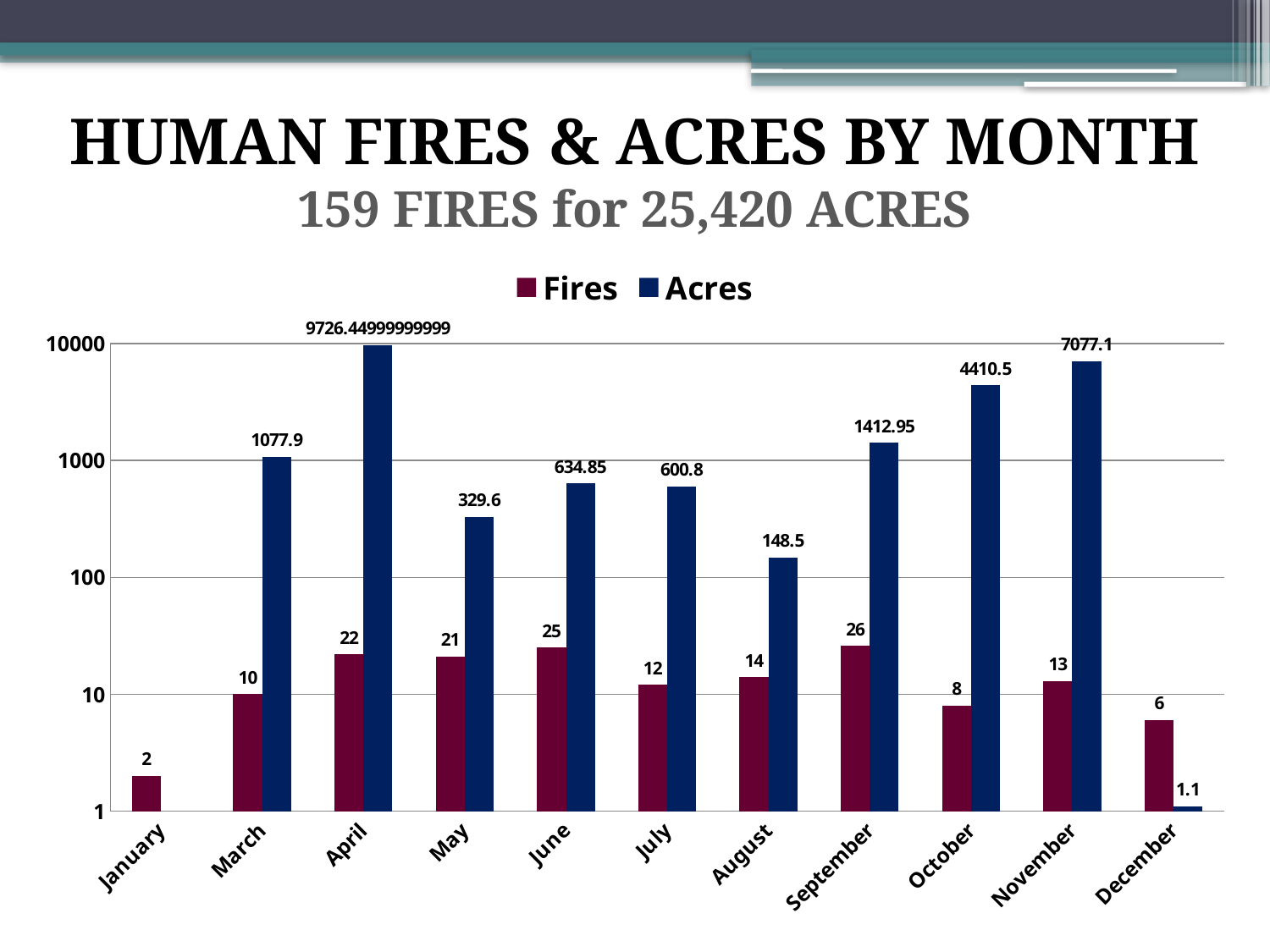
What is the Acres value for October? 4410.5 What is the title of the chart on the slide? HUMAN FIRES & ACRES BY MONTH What is the number of Fires in September? 26 Which month has the lowest number of Fires? January Which is larger, the Acres value for March or for September? September What kind of chart is shown on the slide? bar chart Which month has the highest Acres value? April How many series does the legend list? 2 Which month has the highest number of Fires? September What is the Acres value for December? 1.1 How many months are shown on the x axis? 11 What is the difference in Fires between June and July? 13